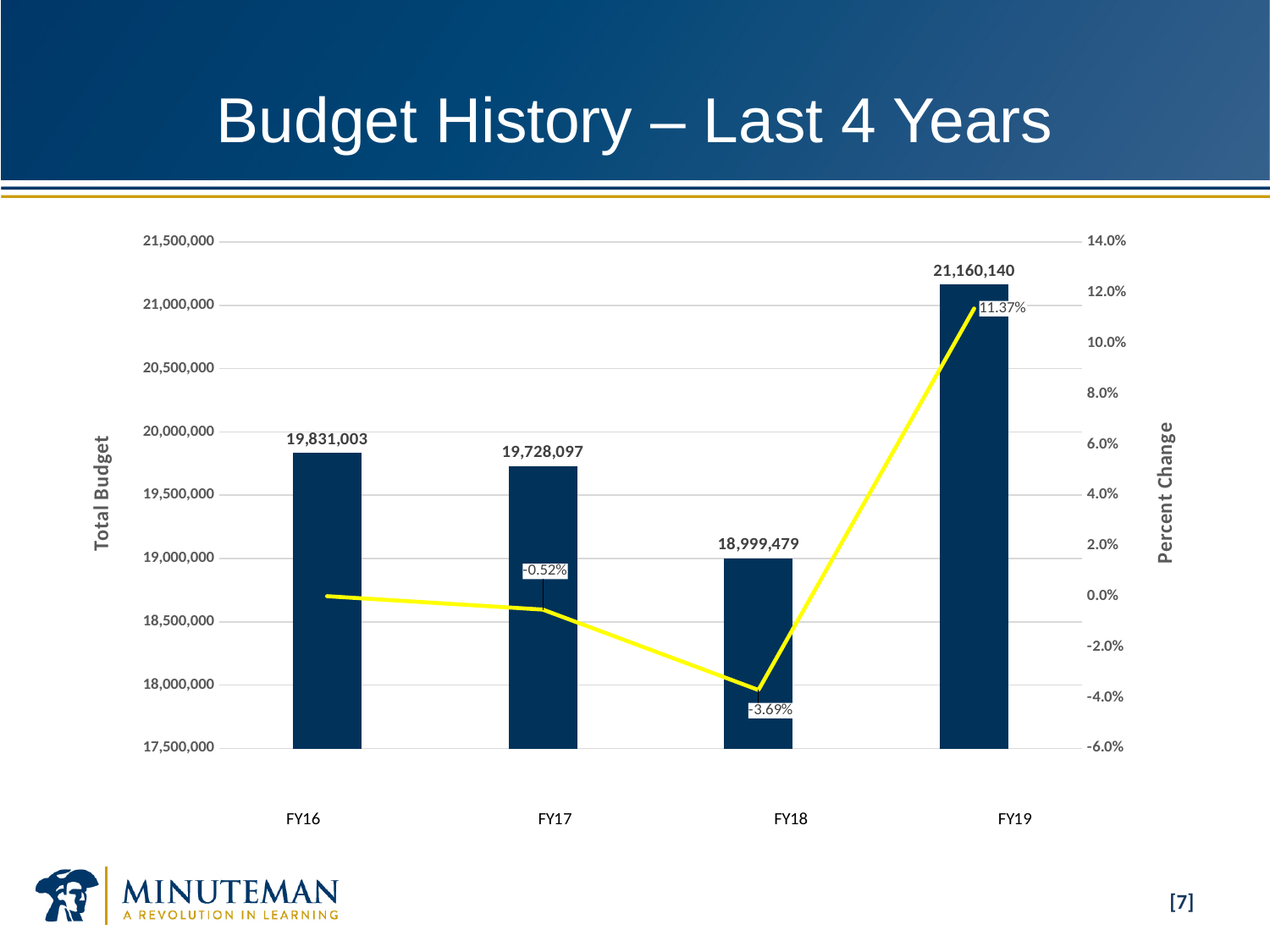
What is the Total Budget for FY19? 21,160,140 How many fiscal years are shown on the x axis? 4 What is the Total Budget for FY16? 19,831,003 What percent change is labelled on the line for FY19? 11.37% What is the difference between the FY19 and FY18 Total Budget values? 2,160,661 What kind of chart is this? bar chart with a line What is the Total Budget for FY18? 18,999,479 Which has the larger Total Budget, FY16 or FY17? FY16 Which fiscal year has the highest Total Budget? FY19 Which fiscal year has the lowest Total Budget? FY18 What is the title of the right-hand vertical axis? Percent Change What percent change is labelled on the line for FY18? -3.69%